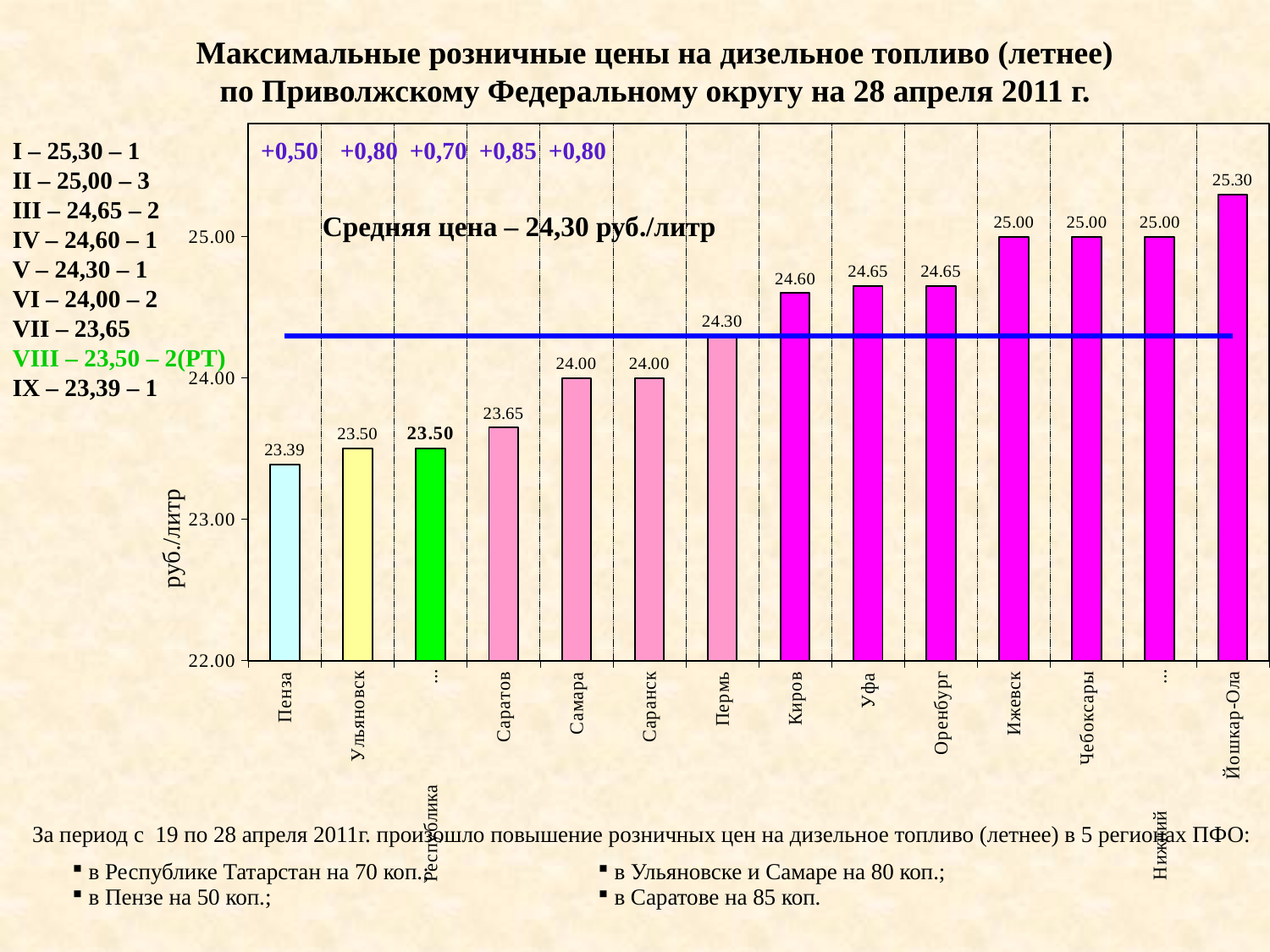
How many bars are shown in the chart? 14 What is the difference between the values for Йошкар-Ола and Пенза? 1.91 What is the value for Йошкар-Ола? 25.30 Which is larger, the value for Ижевск or the value for Оренбург? Ижевск What is the difference between the values for Уфа and Саратов? 1.00 What is the value for Киров? 24.60 Is the value for Самара greater or less than 25.00? less What kind of chart is shown on the slide? bar chart What is the value for Пермь? 24.30 Which category has the highest value? Йошкар-Ола What is the value for Пенза? 23.39 Which category has the lowest value? Пенза